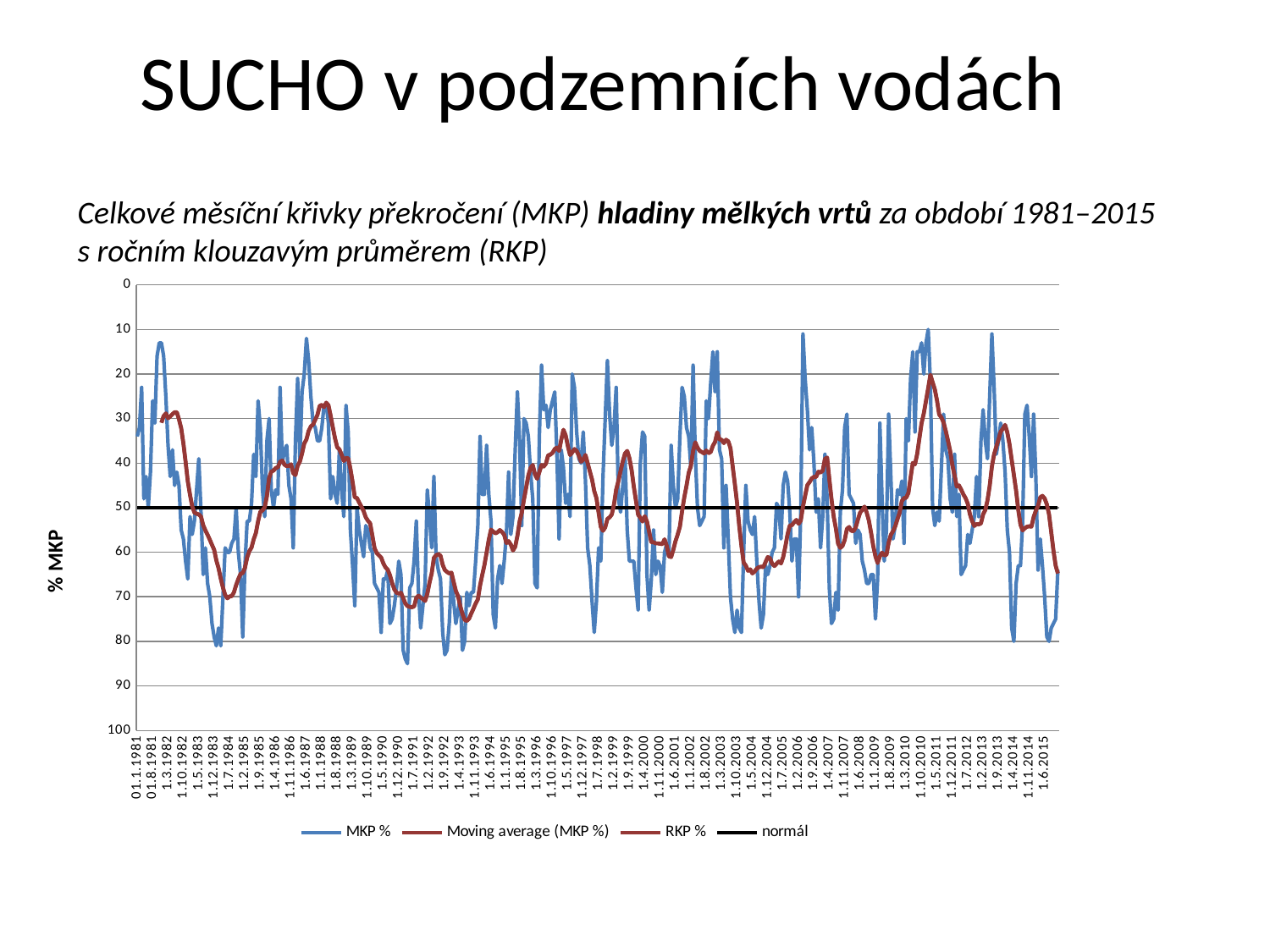
Between 1.1.1988 and 1.7.1991, does the RKP % value rise or fall? rise Is the RKP % value around 1.1.1988 greater or less than 40? less Between 1.7.1984 and 1.1.1988, does the RKP % value rise or fall? fall What is the maximum value shown on the vertical axis of the chart? 100 What is the label of the vertical axis of the chart? % MKP What colour is the MKP % line in the chart? blue How many series does the chart legend list? 4 At which value on the vertical axis is the horizontal 'normál' line drawn? 50 Is the RKP % value around 1.5.2011 greater or less than 30? less Is the RKP % value around 1.7.1984 greater or less than 60? greater What kind of chart is shown on the slide? line chart